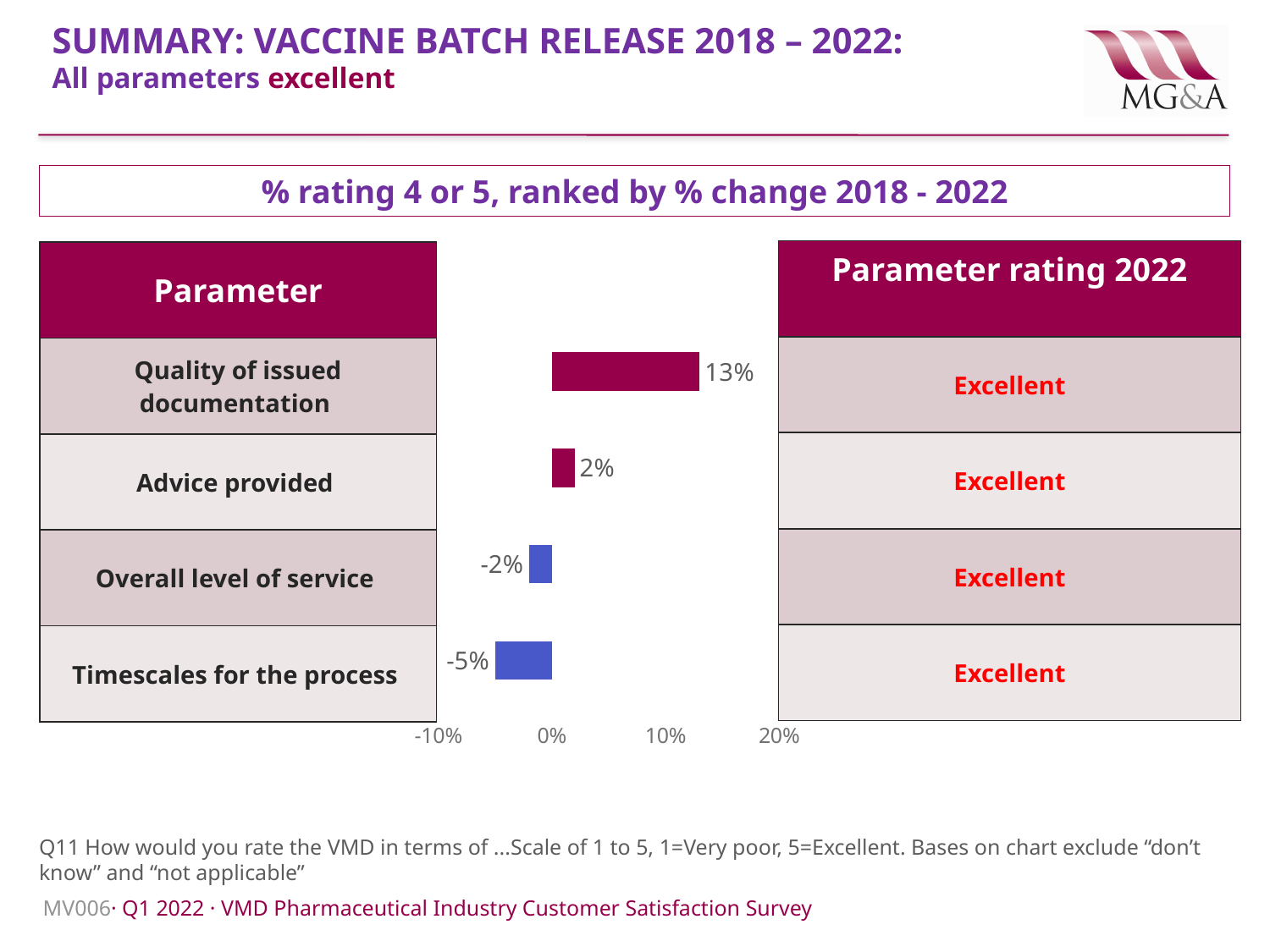
What is the % change 2018 - 2022 for Advice provided? 2% How many parameters are shown in the chart? 4 What is the % change 2018 - 2022 for Overall level of service? -2% What kind of chart is shown on the slide? Bar chart Is the % change for Quality of issued documentation greater or less than 10%? greater What is the difference between the % change for Quality of issued documentation and Advice provided? 11 percentage points Which parameter has the highest % change 2018 - 2022? Quality of issued documentation Which has a larger % change 2018 - 2022: Advice provided or Overall level of service? Advice provided What is the % change 2018 - 2022 for Quality of issued documentation? 13% What is the % change 2018 - 2022 for Timescales for the process? -5% What is the Parameter rating 2022 for Timescales for the process? Excellent Which parameter has the lowest % change 2018 - 2022? Timescales for the process